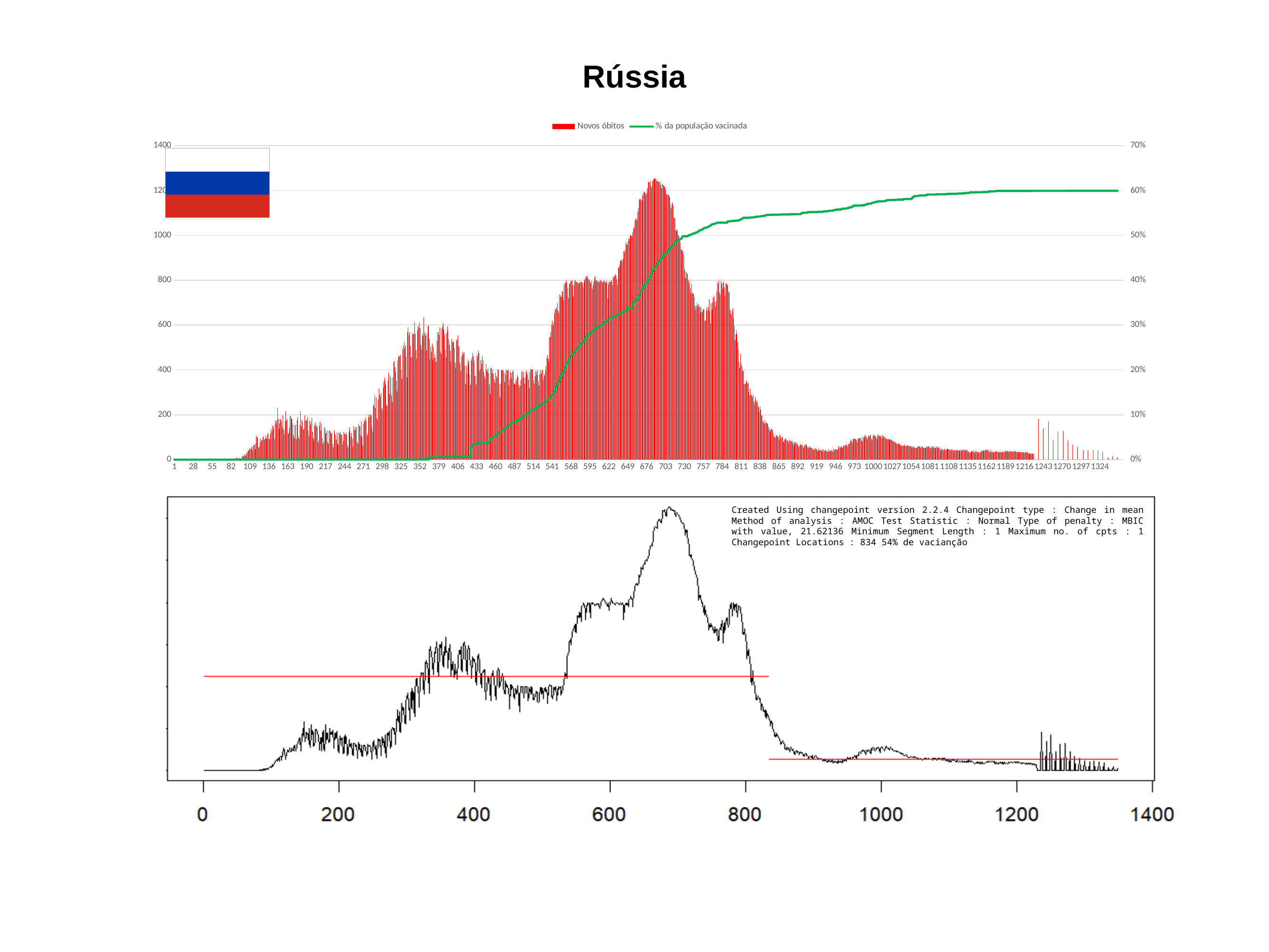
In the bottom chart, what penalty value is stated in the annotation? 21.62136 In the top chart, is the highest 'Novos óbitos' bar greater or less than 1200? greater In the top chart, does the '% da população vacinada' line rise or fall along the x axis? rise In the top chart, what kind of chart is used for the 'Novos óbitos' series? bar chart In the top chart, is the '% da população vacinada' value at the right end of the x axis greater or less than 50%? greater In the top chart, what colour is the '% da população vacinada' line? green In the top chart, what is the maximum value shown on the right-hand axis? 70% In the bottom chart, what vaccination percentage is given next to the changepoint location? 54% In the top chart, how many series does the legend list? 2 In the bottom chart, what changepoint location is reported in the annotation? 834 In the top chart, is the 'Novos óbitos' value around day 1000 greater or less than 200? less In the top chart, what are the two legend entries? Novos óbitos; % da população vacinada